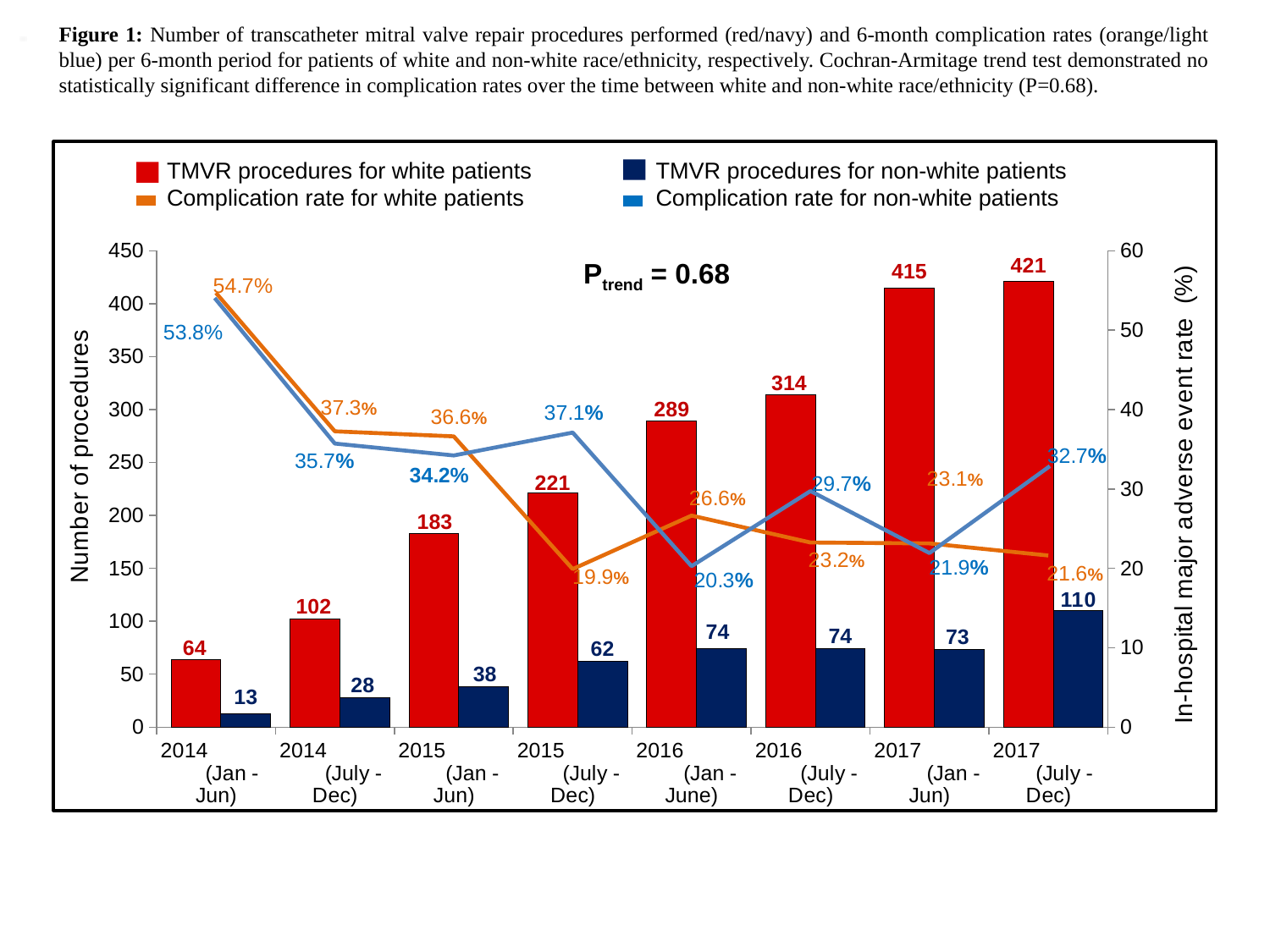
Do the numbers of TMVR procedures for white patients rise or fall from 2014 (Jan - Jun) to 2017 (July - Dec)? Rise In 2015 (July - Dec), which group had the higher complication rate, white or non-white patients? Non-white patients What kind of chart is this? Combined bar and line chart In which period was the number of TMVR procedures for non-white patients lowest? 2014 (Jan - Jun) What was the complication rate for white patients in 2014 (Jan - Jun)? 54.7% How many TMVR procedures were performed for non-white patients in 2016 (Jan - June)? 74 What P trend value is printed on the chart? 0.68 What is the difference between the number of TMVR procedures for white patients and for non-white patients in 2015 (Jan - Jun)? 145 How many 6-month periods are shown on the x axis? 8 How many TMVR procedures were performed for white patients in 2017 (July - Dec)? 421 In which period was the number of TMVR procedures for white patients highest? 2017 (July - Dec) How many series does the legend list? 4